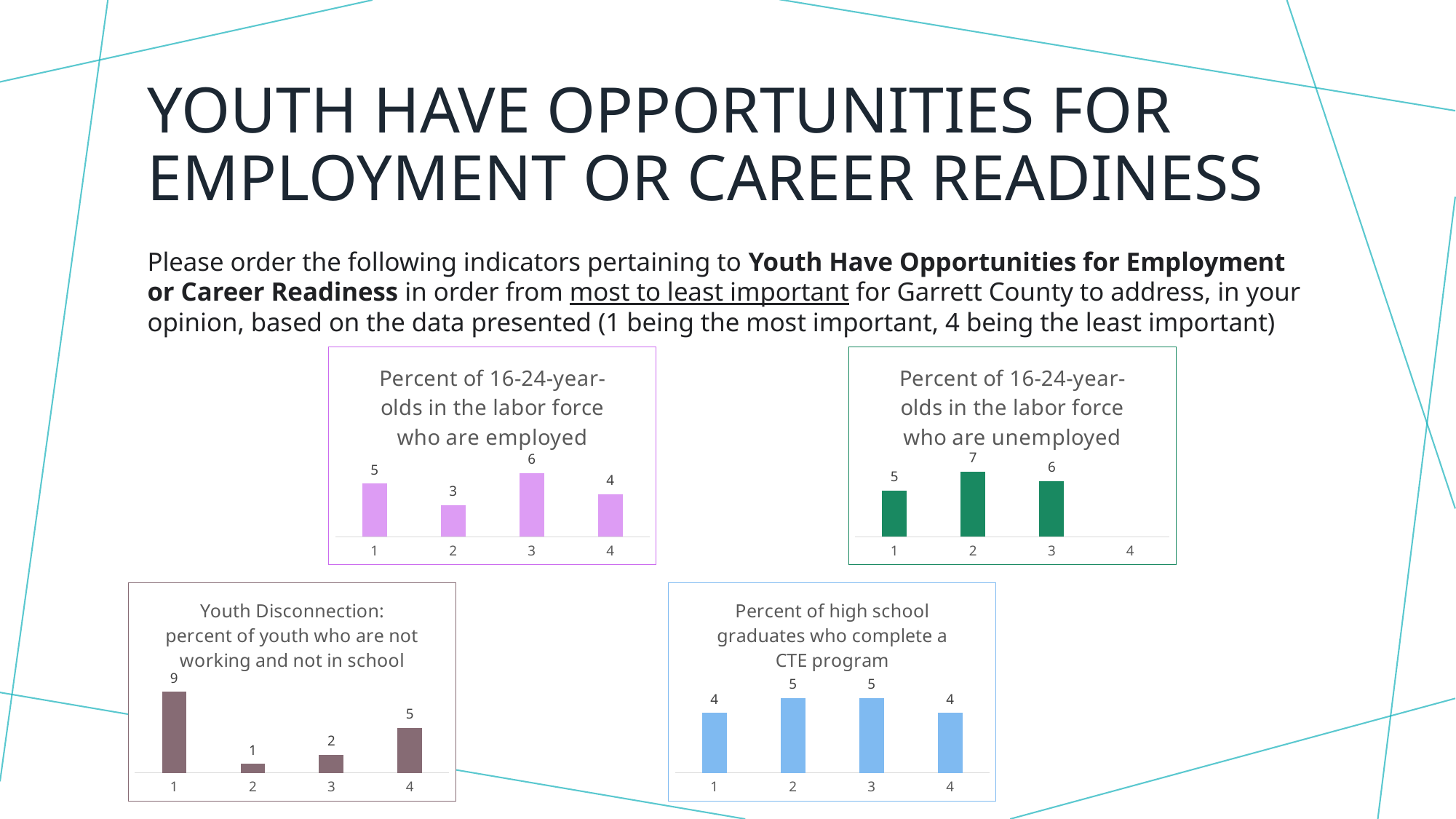
In the chart titled "Youth Disconnection: percent of youth who are not working and not in school", what is the value for category 1? 9 In the chart titled "Youth Disconnection: percent of youth who are not working and not in school", which category has the lowest value? 2 In the chart titled "Percent of 16-24-year-olds in the labor force who are employed", which category has the lowest value? 2 In the chart titled "Percent of high school graduates who complete a CTE program", what is the value for category 2? 5 What kind of chart is the one titled "Youth Disconnection: percent of youth who are not working and not in school"? bar chart In the chart titled "Percent of high school graduates who complete a CTE program", is the value for category 1 larger or smaller than the value for category 2? smaller In the chart titled "Percent of 16-24-year-olds in the labor force who are unemployed", what is the difference between the values for category 2 and category 1? 2 In the chart titled "Percent of 16-24-year-olds in the labor force who are unemployed", what is the value for category 2? 7 In the chart titled "Youth Disconnection: percent of youth who are not working and not in school", what is the difference between the values for category 1 and category 4? 4 How many charts are shown on the slide? 4 In the chart titled "Percent of 16-24-year-olds in the labor force who are employed", what is the value for category 3? 6 In the chart titled "Percent of 16-24-year-olds in the labor force who are unemployed", which category has the highest value? 2